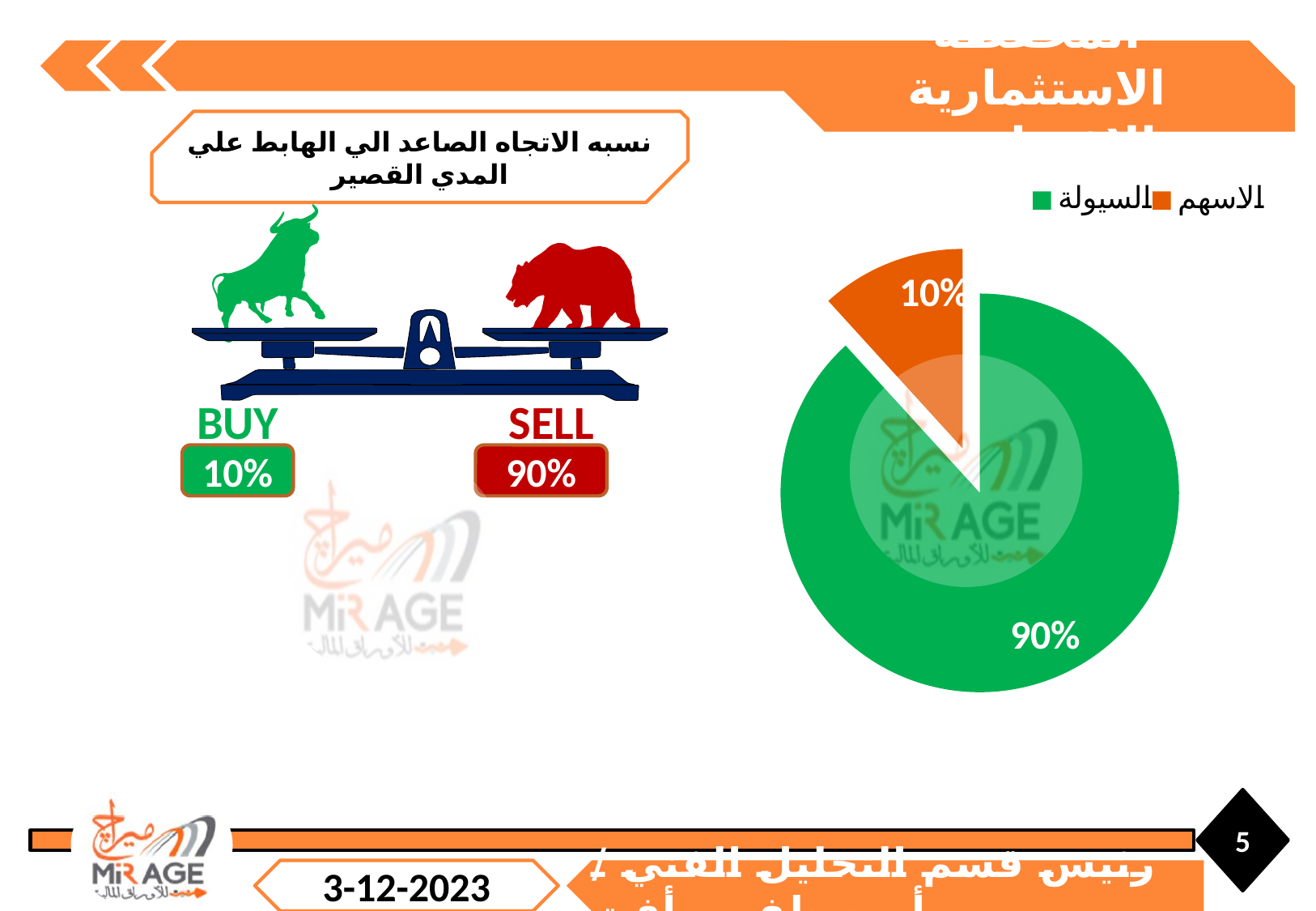
In the pie chart, which is larger: السيولة or الاسهم? السيولة How many slices does the pie chart have? 2 What is the difference in percentage points between the السيولة slice and the الاسهم slice in the pie chart? 80 Which slice of the pie chart is the smallest? الاسهم What colour is the السيولة slice in the pie chart? green In the pie chart, what share is shown for السيولة? 90% Which slice of the pie chart is the largest? السيولة In the pie chart, what share is shown for الاسهم? 10% How many entries does the pie chart's legend list? 2 What colour is the الاسهم slice in the pie chart? orange What kind of chart is shown on the right side of the slide? pie chart